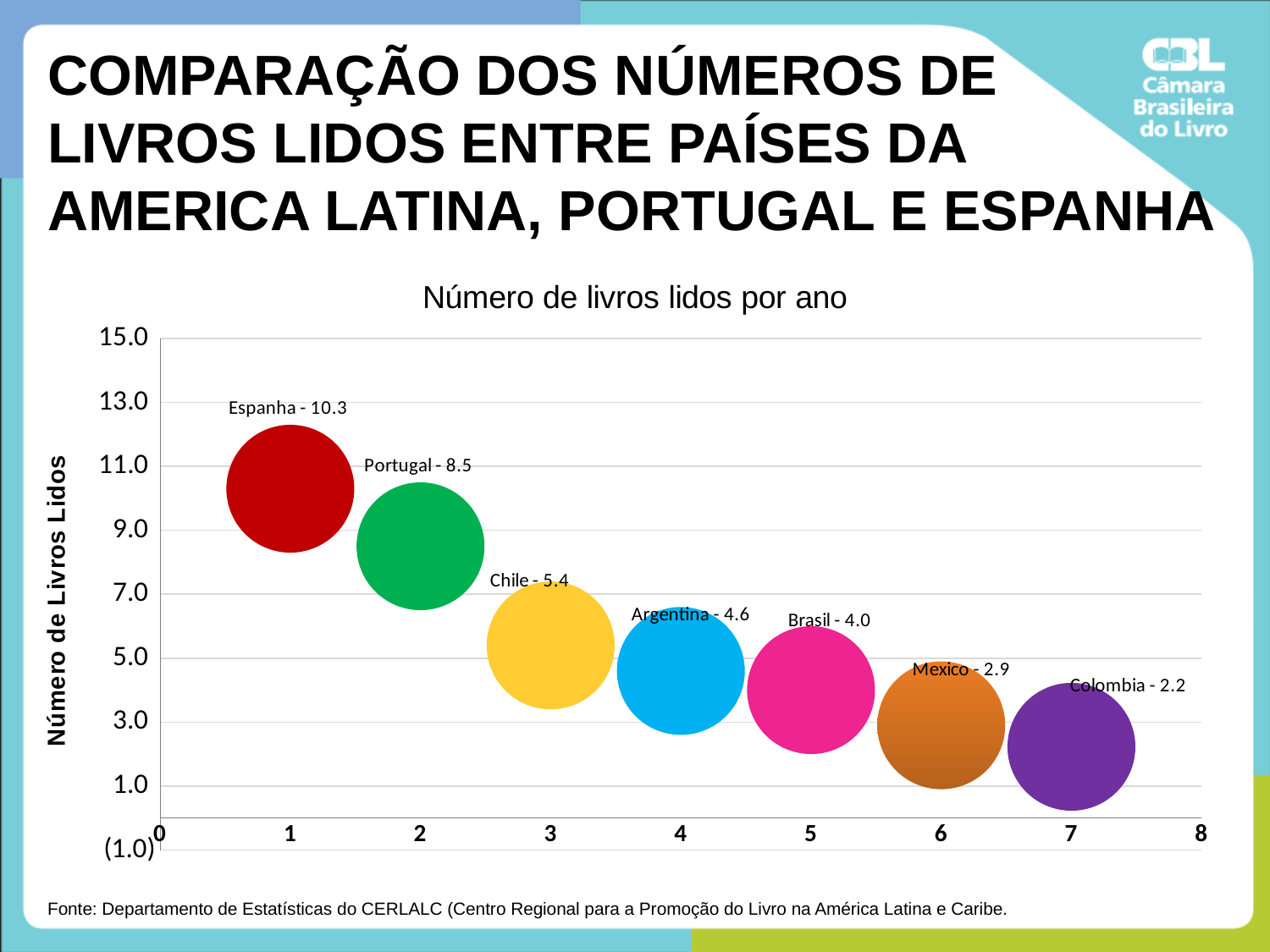
Which has a higher value, Argentina or Brasil? Argentina How many countries are plotted on the chart? 7 What is the number of books read per year for Espanha? 10.3 Which country has the lowest number of books read per year? Colombia What is the title of the chart? Número de livros lidos por ano What is the number of books read per year for Chile? 5.4 What is the difference between the values for Brasil and Mexico? 1.1 What kind of chart is shown on the slide? Bubble chart Which country has the highest number of books read per year? Espanha Is the value for Portugal greater or less than 7.0? greater What is the difference between the values for Espanha and Portugal? 1.8 What is the number of books read per year for Colombia? 2.2